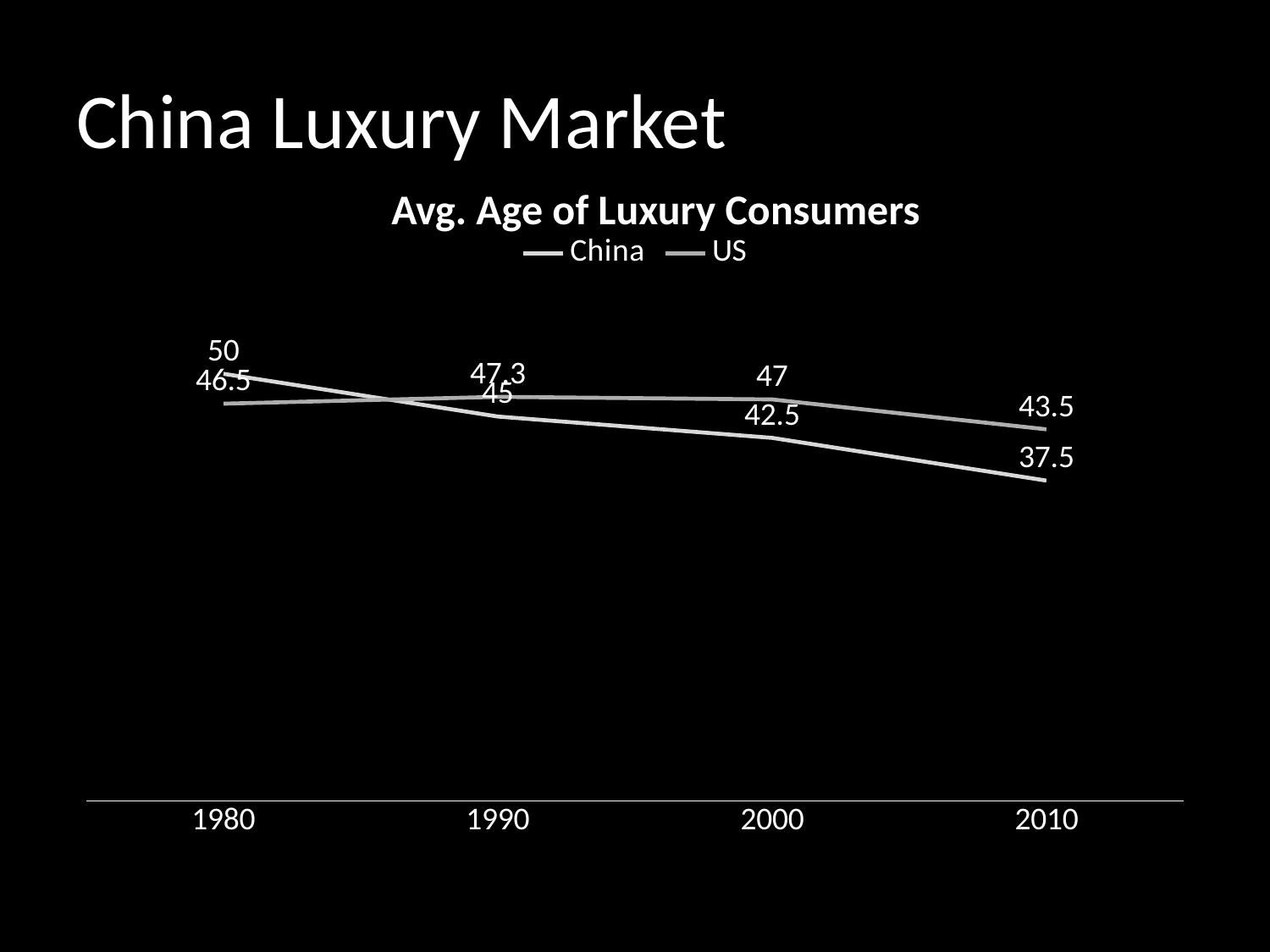
Which is larger: the value 47 at 2000 or the value 43.5 at 2010? 47 at 2000 What is the title of the chart? Avg. Age of Luxury Consumers For the series that starts at 50 in 1980, what is its value in 2000? 42.5 How many series does the chart legend list? 2 For the series that starts at 50 in 1980, does its value rise or fall from 1980 to 2010? fall What kind of chart is shown on the slide? line chart What is the lower of the two values labelled at 2010? 37.5 What is the higher of the two values labelled at 1980? 50 For the series that starts at 46.5 in 1980, what is its value in 1990? 47.3 How many years are shown on the x axis of the chart? 4 Which two series are listed in the chart legend? China and US What is the difference between the two values labelled at 2010? 6